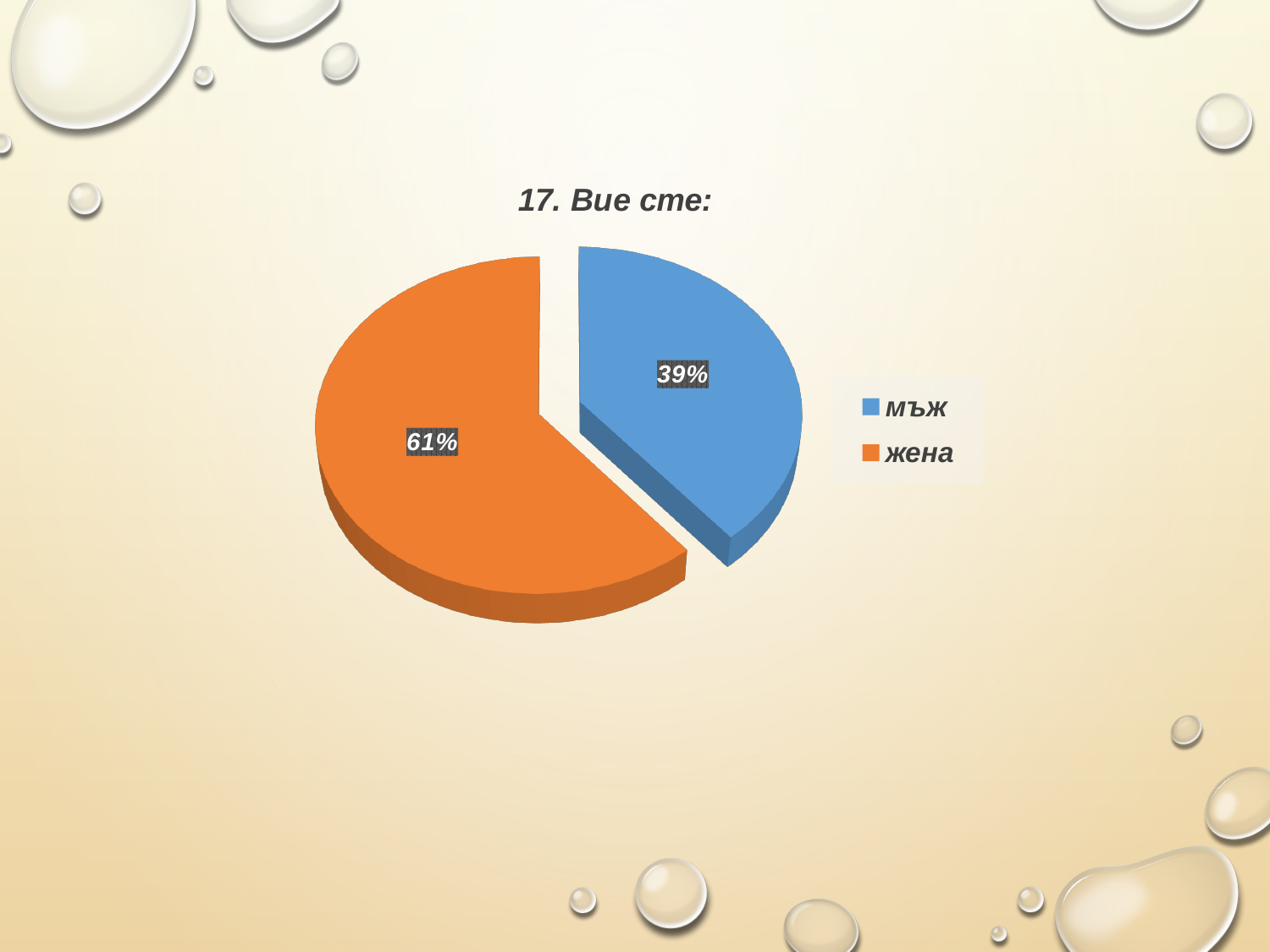
Which is larger, the share for мъж or the share for жена? жена What share of the pie does the мъж slice represent? 39% What percentage is shown for жена? 61% What colour is the slice for жена? orange Which category has the largest share of the pie? жена What is the title of the chart? 17. Вие сте: How many slices does the pie chart have? 2 What kind of chart is shown on the slide? pie chart How many entries does the legend list? 2 Which category has the smallest share of the pie? мъж What percentage is shown for мъж? 39% What is the difference in percentage points between жена and мъж? 22